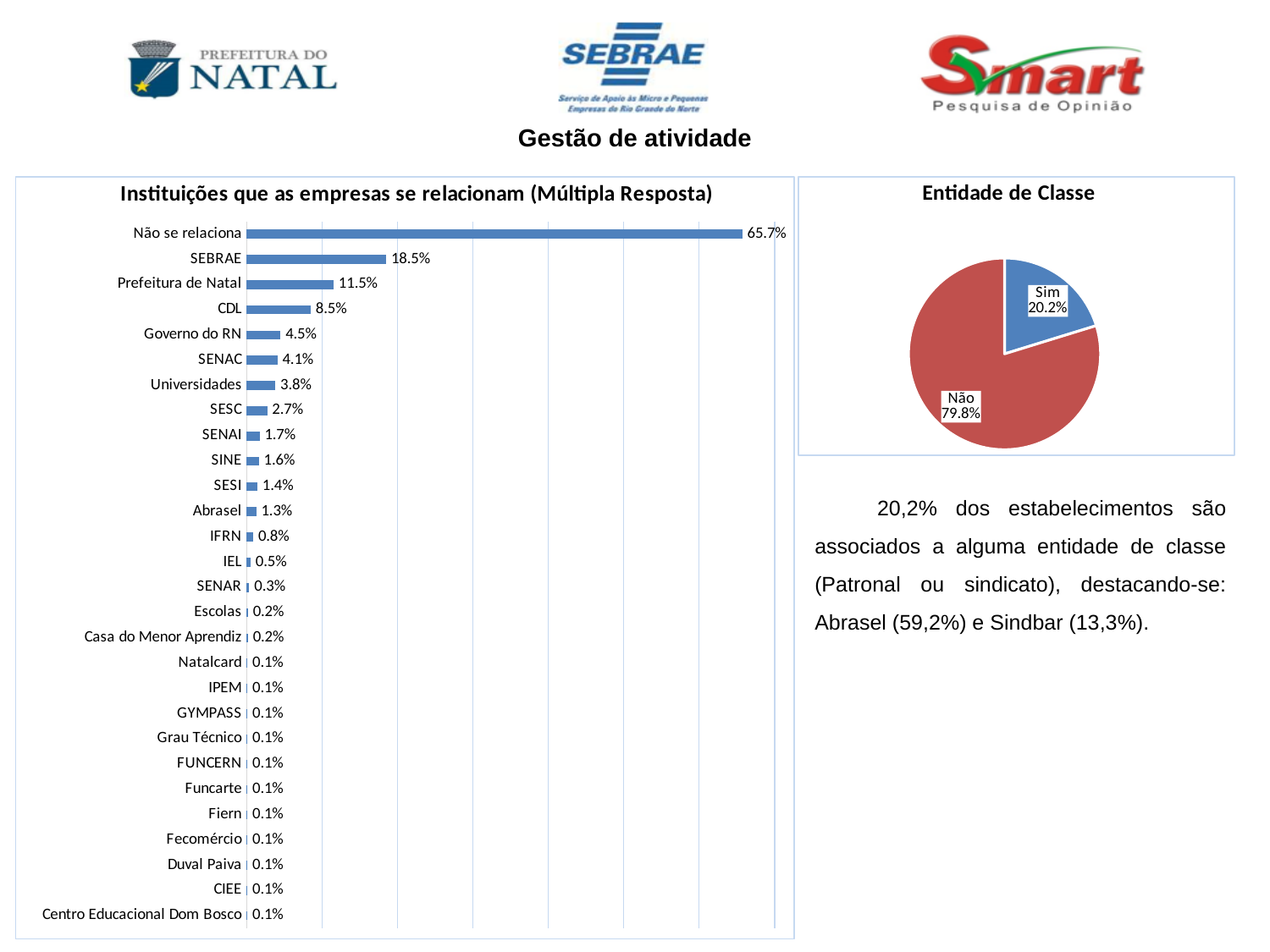
In the chart 'Instituições que as empresas se relacionam (Múltipla Resposta)', what is the value for Prefeitura de Natal? 11.5% In the chart 'Instituições que as empresas se relacionam (Múltipla Resposta)', what is the value for SEBRAE? 18.5% In the chart 'Entidade de Classe', which slice is larger, 'Sim' or 'Não'? Não In the chart 'Instituições que as empresas se relacionam (Múltipla Resposta)', what is the value for Universidades? 3.8% In the chart 'Instituições que as empresas se relacionam (Múltipla Resposta)', which is larger, the value for Governo do RN or the value for SESC? Governo do RN In the chart 'Entidade de Classe', what is the share for 'Não'? 79.8% What kind of chart is 'Entidade de Classe'? Pie chart In the chart 'Instituições que as empresas se relacionam (Múltipla Resposta)', what is the difference between the values for SEBRAE and CDL? 10.0% In the chart 'Entidade de Classe', what is the share for 'Sim'? 20.2% How many categories are shown in the chart 'Instituições que as empresas se relacionam (Múltipla Resposta)'? 28 In the chart 'Instituições que as empresas se relacionam (Múltipla Resposta)', which category has the highest value? Não se relaciona What kind of chart is 'Instituições que as empresas se relacionam (Múltipla Resposta)'? Bar chart